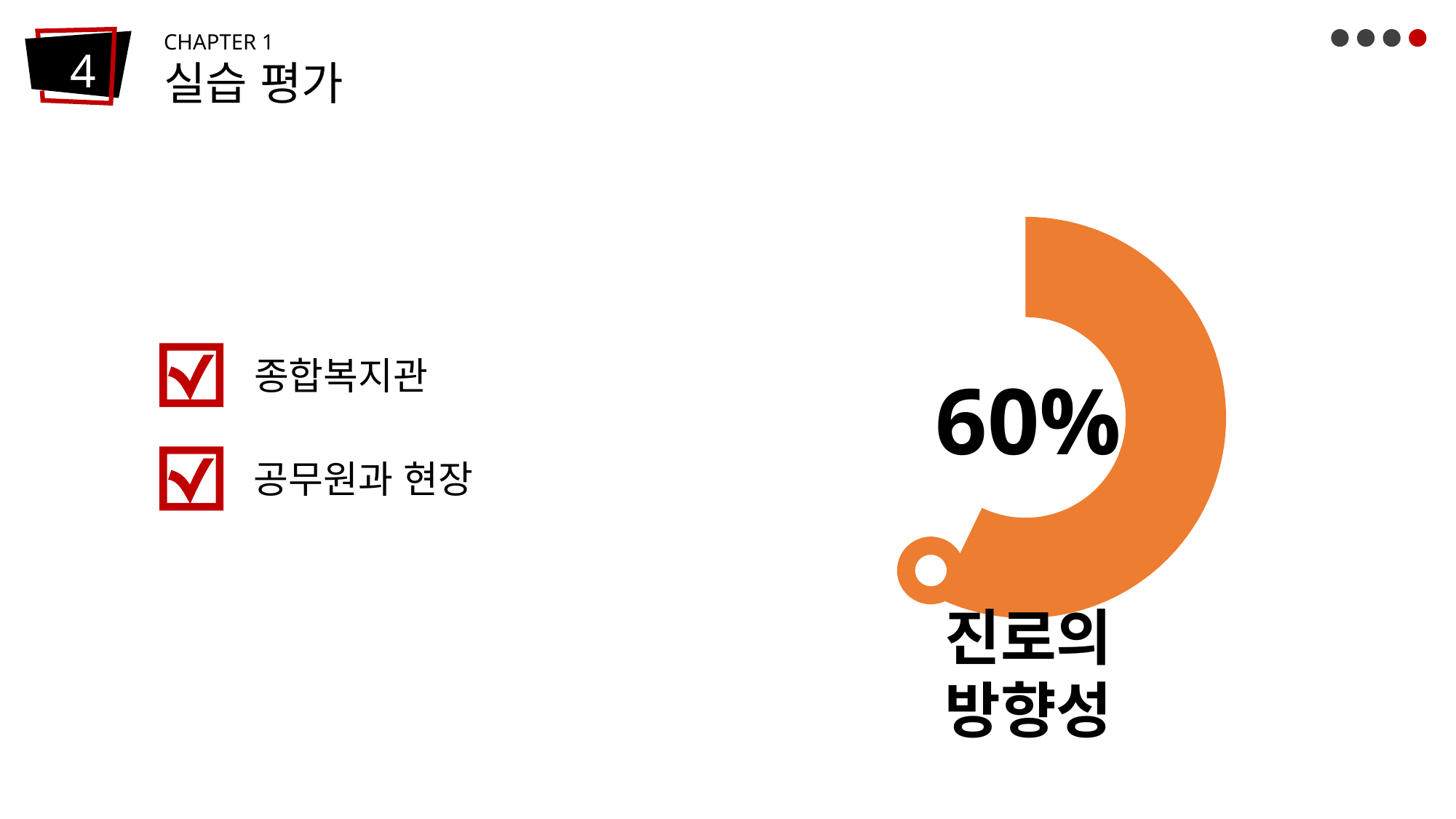
What percentage is displayed in the centre of the orange ring chart? 60% What colour is the filled portion of the ring chart? orange Is the value shown in the ring chart greater or less than 50%? greater What kind of chart is shown on the right of the slide? donut chart What label appears below the orange ring chart? 진로의 방향성